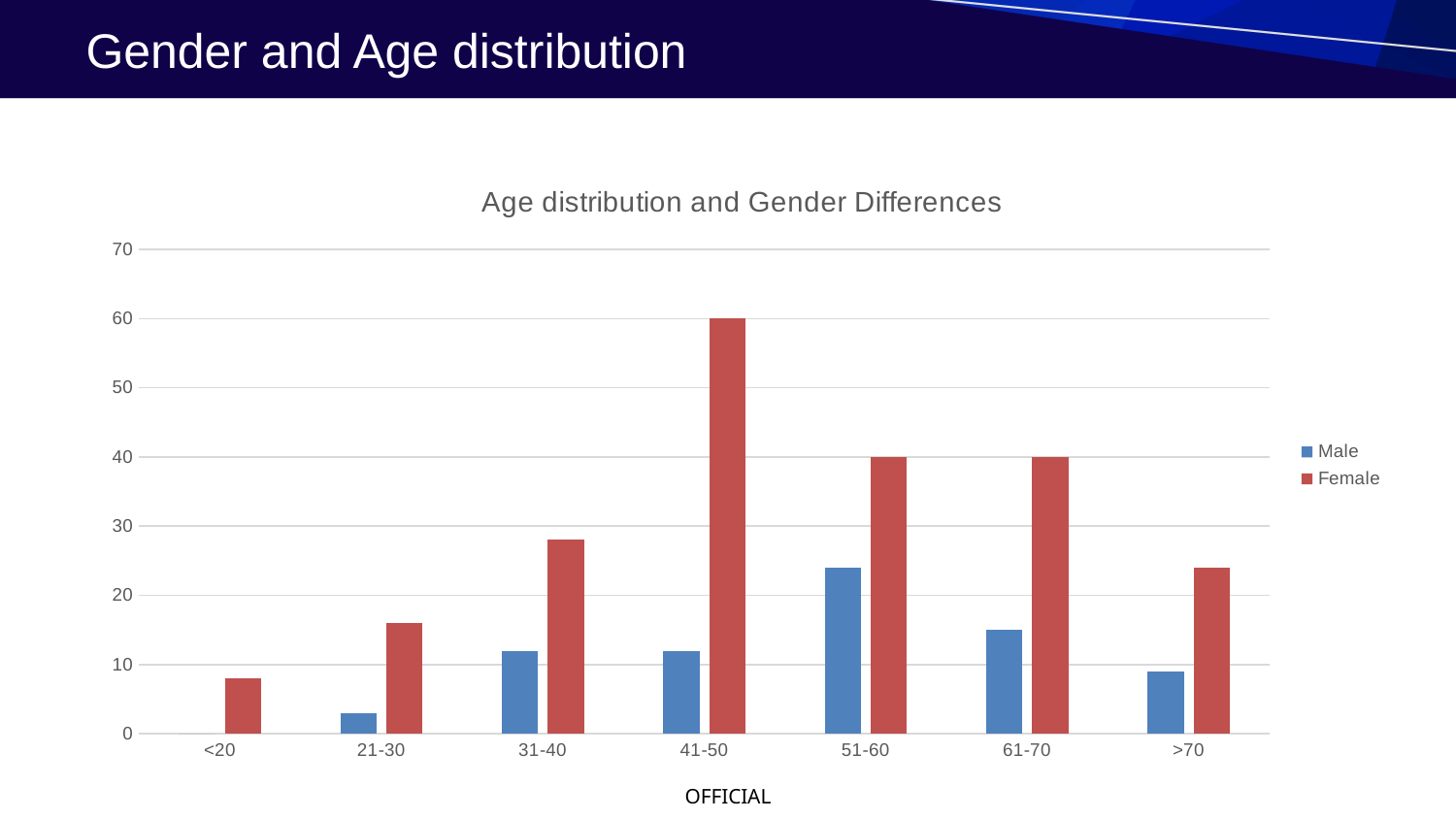
What type of chart is shown on the slide? Bar chart Is the Female value for the 31-40 age group greater or less than 30? less Which age group has the highest Male value? 51-60 How many series does the legend list? 2 What is the title of the chart? Age distribution and Gender Differences Which age group has the lowest Female value? <20 What is the Female value for the 41-50 age group? 60 What is the Female value for the 51-60 age group? 40 Is the Male value for the 51-60 age group greater or less than 20? greater Which age group has the highest Female value? 41-50 How many age categories are shown on the x axis? 7 Which is larger, the Male value for 51-60 or the Male value for 61-70? 51-60